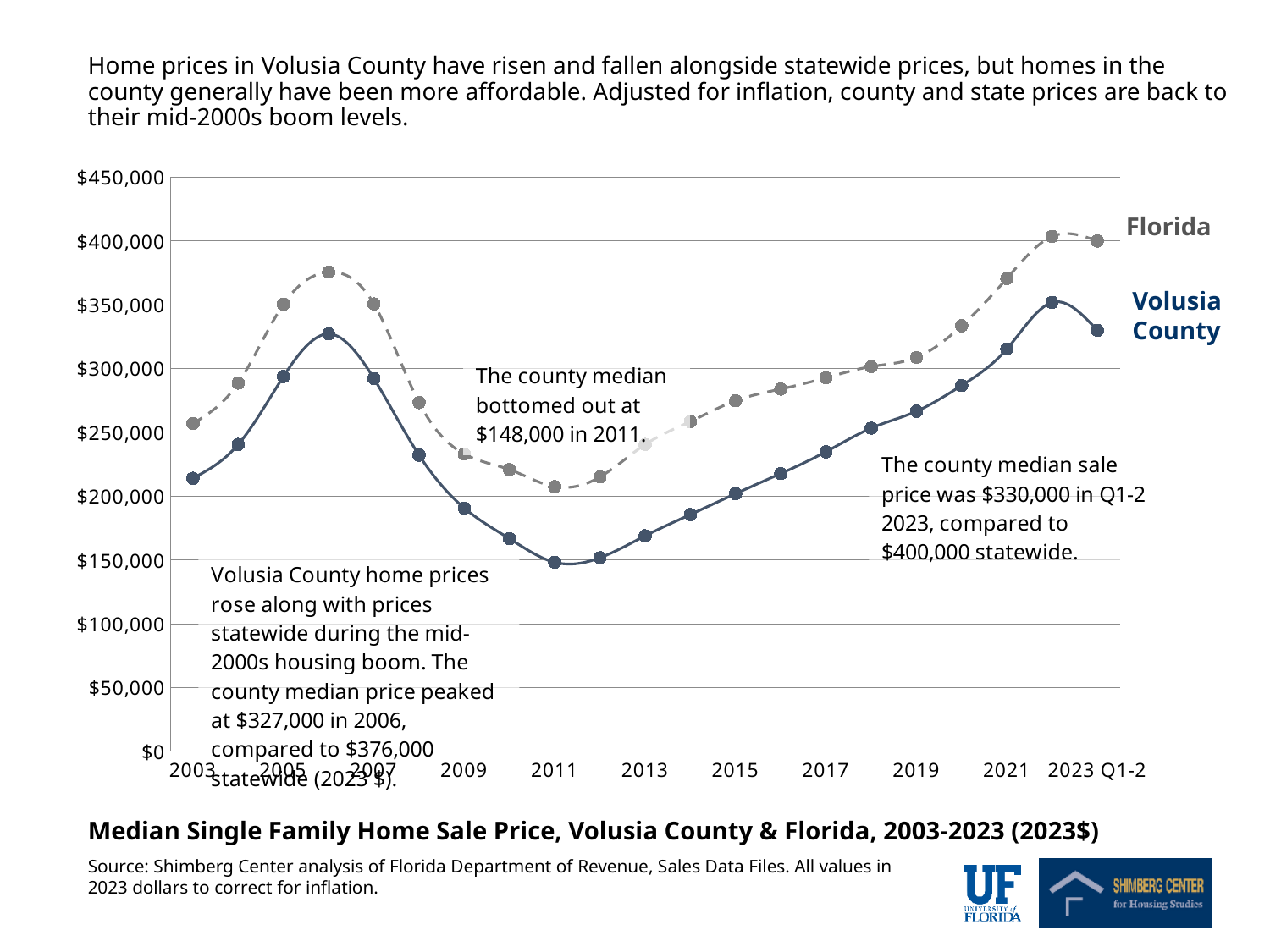
How much higher was the Florida median than the Volusia County median in Q1-2 2023? $70,000 How many series are plotted on the chart? 2 What was the Volusia County median sale price in Q1-2 2023? $330,000 What is the difference between the Florida and Volusia County medians in 2006? $49,000 Is the Volusia County value for 2003 greater or less than $250,000? less What was the Florida statewide median price in 2006, according to the chart annotation? $376,000 At what value did the Volusia County median price peak in 2006? $327,000 In which year was the Volusia County median sale price lowest? 2011 What was the Volusia County median sale price in 2011, according to the chart annotation? $148,000 What is the title of the chart? Median Single Family Home Sale Price, Volusia County & Florida, 2003-2023 (2023$) What kind of chart is shown on the slide? line chart What was the Florida statewide median sale price in Q1-2 2023? $400,000